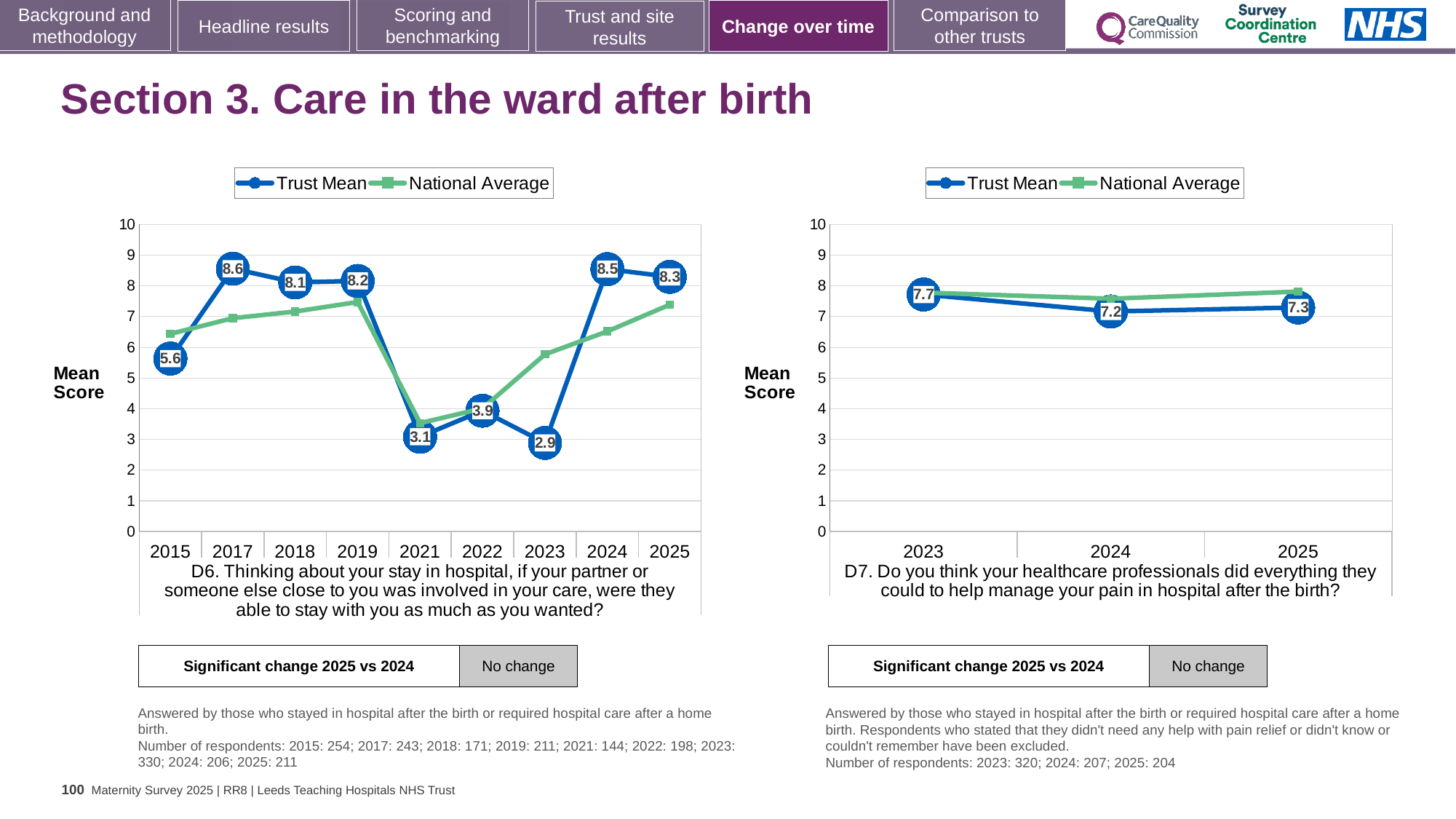
In the D6 chart, which year has the highest Trust Mean? 2017 In the D6 chart, what is the Trust Mean for 2017? 8.6 In the D7 chart, what is the Trust Mean for 2024? 7.2 In the D7 chart, which year has the highest Trust Mean? 2023 In the D6 chart, is the National Average for 2015 greater or less than 6? greater In the D7 chart, what is the difference between the Trust Mean for 2023 and the Trust Mean for 2025? 0.4 In the D6 chart, what is the difference between the Trust Mean for 2024 and the Trust Mean for 2021? 5.4 In the D6 chart, how many years are shown on the x axis? 9 In the D6 chart, what is the Trust Mean for 2023? 2.9 How many series does the legend of the D7 chart list? 2 In the D6 chart, which year has the lowest Trust Mean? 2023 What kind of chart is the D7 chart? Line chart